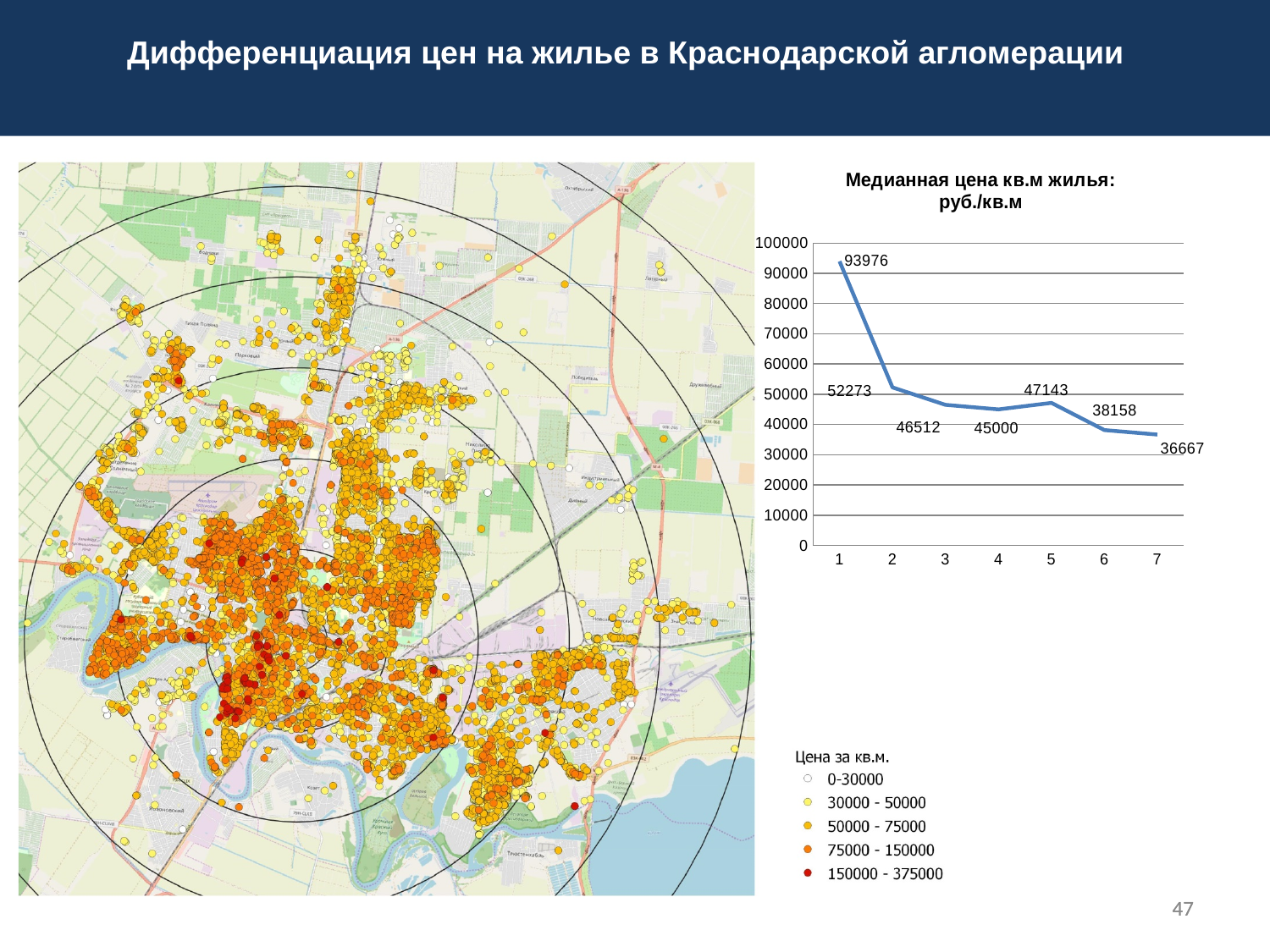
In the chart 'Медианная цена кв.м жилья: руб./кв.м', what is the difference between the values at x = 1 and x = 2? 41703 In the chart 'Медианная цена кв.м жилья: руб./кв.м', what is the value at x = 4? 45000 What type of chart is 'Медианная цена кв.м жилья: руб./кв.м'? Line chart In the chart 'Медианная цена кв.м жилья: руб./кв.м', do the values generally rise or fall from x = 1 to x = 7? Fall In the chart 'Медианная цена кв.м жилья: руб./кв.м', which is larger: the value at x = 3 or the value at x = 5? x = 5 In the chart 'Медианная цена кв.м жилья: руб./кв.м', how many data points are plotted? 7 In the chart 'Медианная цена кв.м жилья: руб./кв.м', what is the value at x = 5? 47143 In the chart 'Медианная цена кв.м жилья: руб./кв.м', at which x value is the median price lowest? 7 In the chart 'Медианная цена кв.м жилья: руб./кв.м', what is the value at x = 1? 93976 In the chart 'Медианная цена кв.м жилья: руб./кв.м', at which x value is the median price highest? 1 In the chart 'Медианная цена кв.м жилья: руб./кв.м', what is the difference between the values at x = 5 and x = 6? 8985 In the chart 'Медианная цена кв.м жилья: руб./кв.м', what is the value at x = 7? 36667